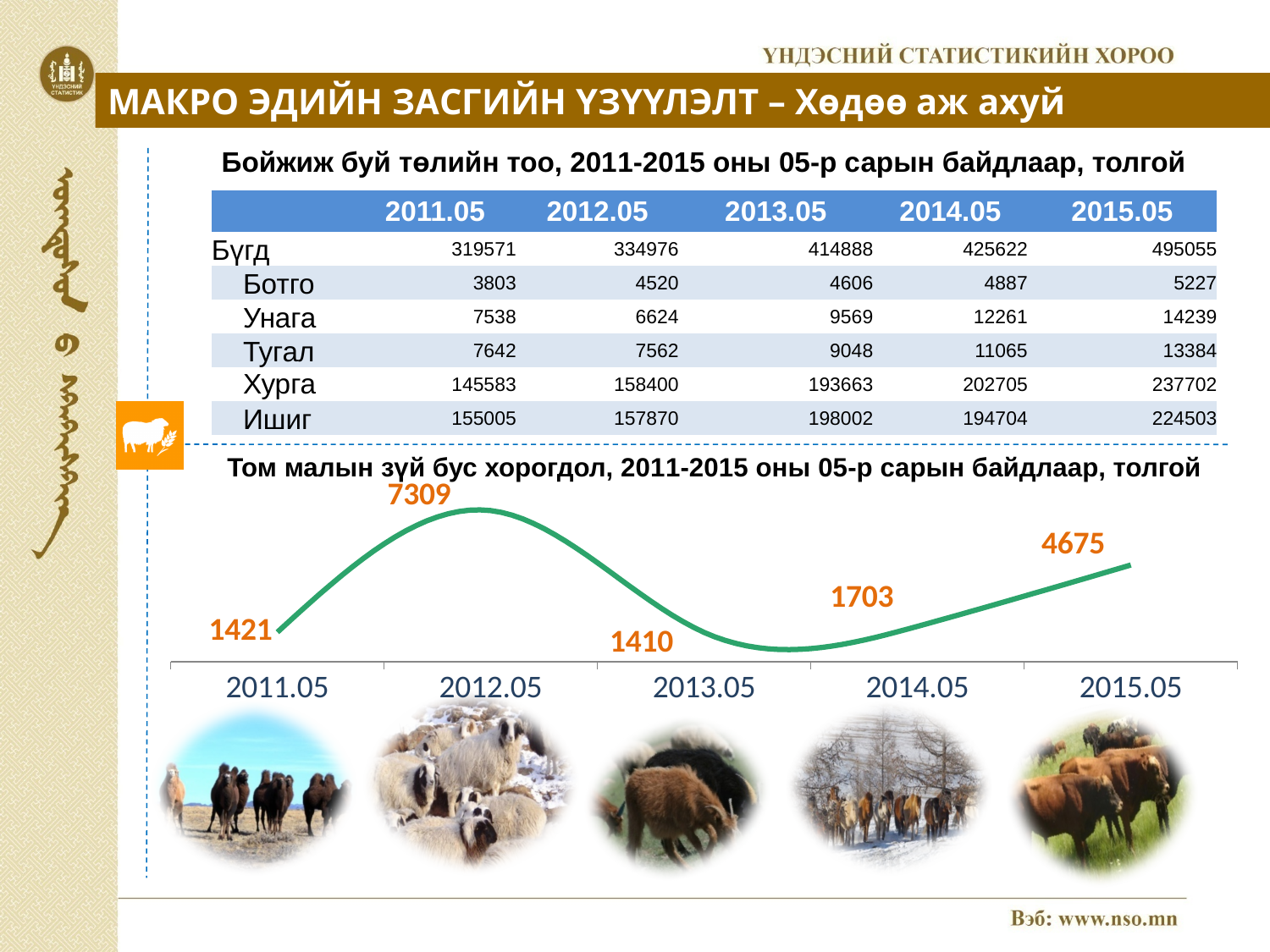
How many data points are plotted in the line chart 'Том малын зүй бус хорогдол'? 5 In the line chart 'Том малын зүй бус хорогдол', what is the value for 2014.05? 1703 In the line chart 'Том малын зүй бус хорогдол', which period has the highest value? 2012.05 In the line chart 'Том малын зүй бус хорогдол', what is the value for 2013.05? 1410 In the line chart 'Том малын зүй бус хорогдол', what is the difference between the values for 2012.05 and 2013.05? 5899 In the line chart 'Том малын зүй бус хорогдол', what is the value for 2015.05? 4675 In the line chart 'Том малын зүй бус хорогдол', what is the value for 2011.05? 1421 In the line chart 'Том малын зүй бус хорогдол', what is the value for 2012.05? 7309 In the line chart 'Том малын зүй бус хорогдол', what is the difference between the values for 2015.05 and 2014.05? 2972 In the line chart 'Том малын зүй бус хорогдол', which period has the lowest value? 2013.05 What kind of chart is used for 'Том малын зүй бус хорогдол, 2011-2015 оны 05-р сарын байдлаар, толгой'? Line chart In the line chart 'Том малын зүй бус хорогдол', which is larger, the value for 2011.05 or 2015.05? 2015.05